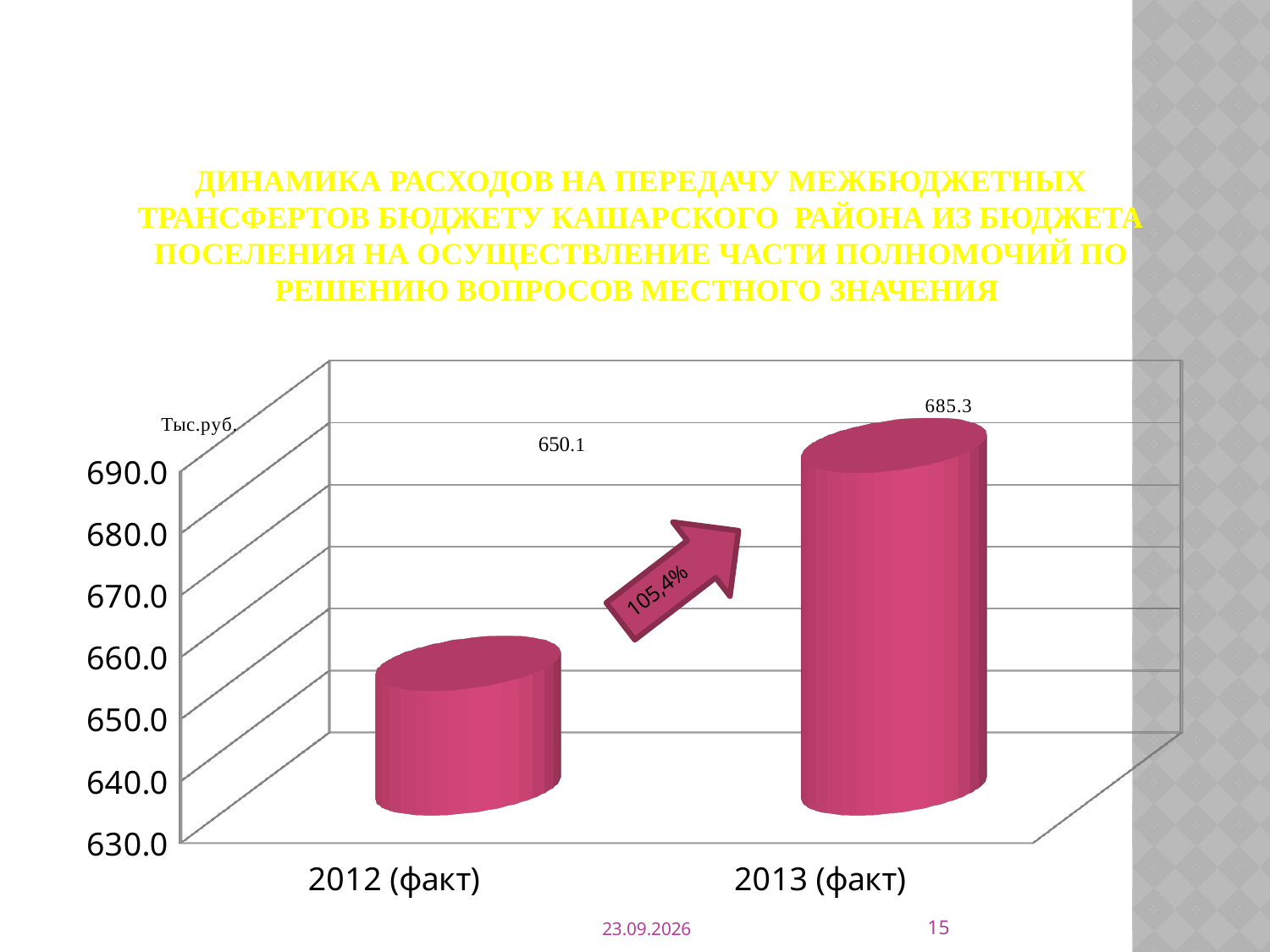
What percentage is written on the arrow between the two bars? 105,4% Which is larger, the value for 2012 (факт) or 2013 (факт)? 2013 (факт) Is the value for 2012 (факт) greater or less than 660.0? less What kind of chart is shown on the slide? bar chart Which category has the highest value? 2013 (факт) Which category has the lowest value? 2012 (факт) What is the difference between the values for 2013 (факт) and 2012 (факт)? 35.2 What is the value for 2012 (факт)? 650.1 How many categories are shown on the x axis? 2 Is the value for 2013 (факт) greater or less than 680.0? greater What is the value for 2013 (факт)? 685.3 Do the values rise or fall from 2012 (факт) to 2013 (факт)? rise